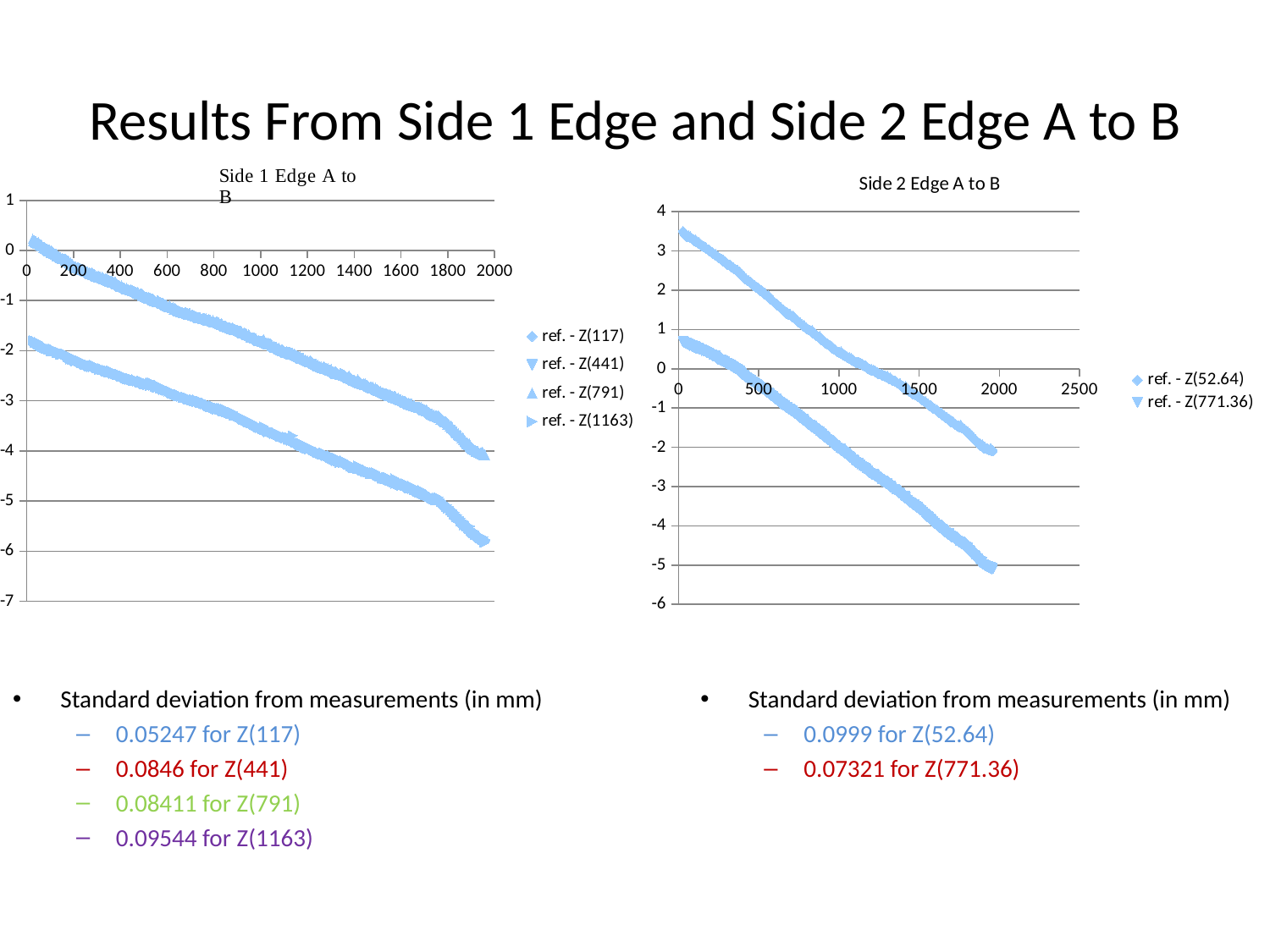
What are the legend entries of the 'Side 2 Edge A to B' chart? ref. - Z(52.64) and ref. - Z(771.36) How many series does the legend of the 'Side 1 Edge A to B' chart list? 4 In the 'Side 1 Edge A to B' chart, is the value of the lower series at x = 0 greater or less than -1? less How many series does the legend of the 'Side 2 Edge A to B' chart list? 2 What kind of chart is the 'Side 2 Edge A to B' chart? scatter chart In the 'Side 2 Edge A to B' chart, do the plotted values rise or fall as the x axis increases? fall In the 'Side 2 Edge A to B' chart, is the value of the lower series at x = 1000 greater or less than -2? less In the 'Side 1 Edge A to B' chart, do the plotted values rise or fall as the x axis increases? fall What kind of chart is the 'Side 1 Edge A to B' chart? scatter chart In the 'Side 1 Edge A to B' chart, is the value of the upper series at x = 1000 greater or less than -1? less What is the title of the chart on the right side of the slide? Side 2 Edge A to B